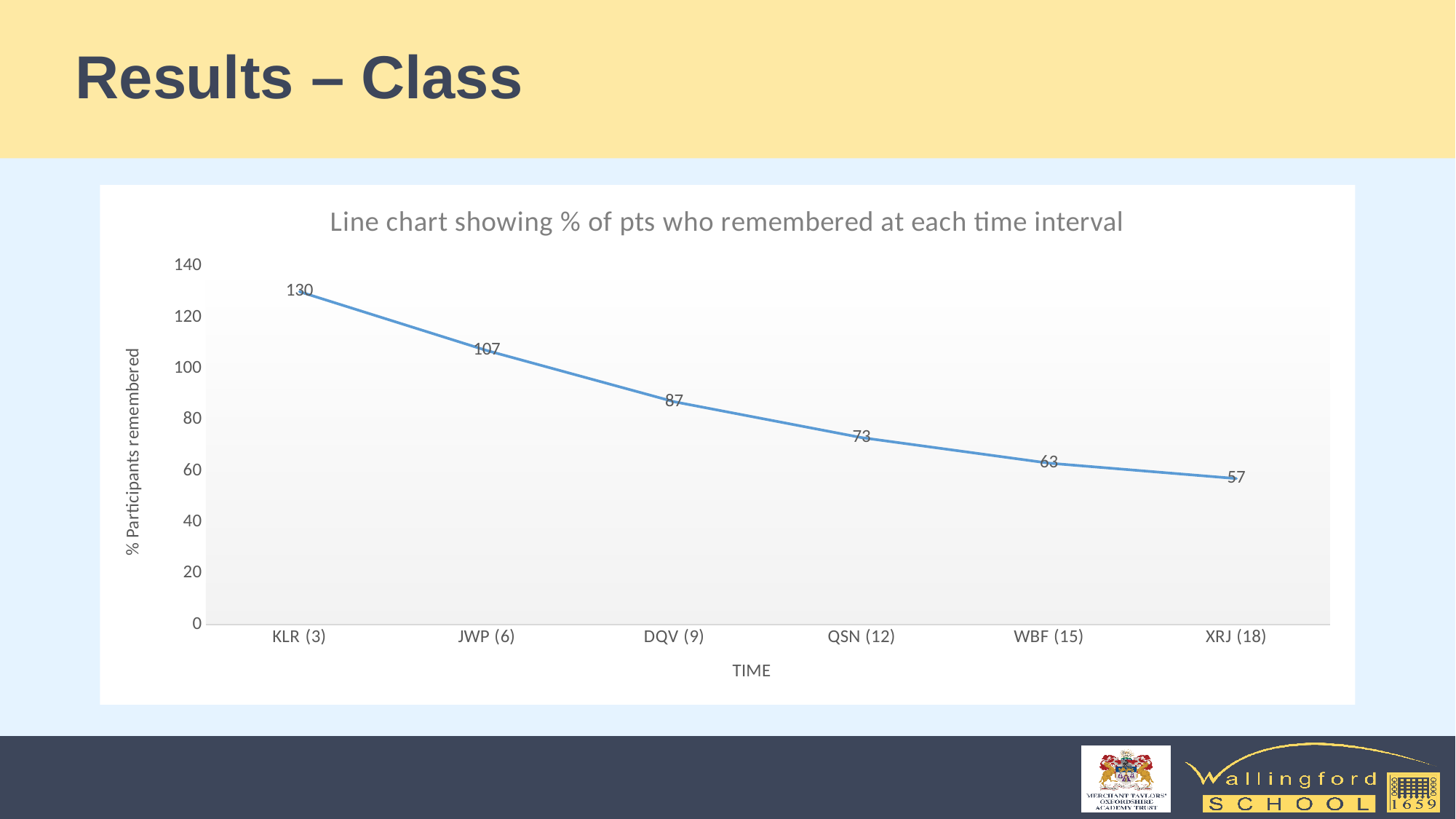
Is the value for QSN (12) greater or less than 80? less What is the value for DQV (9)? 87 Which is larger, the value for JWP (6) or the value for DQV (9)? JWP (6) Which time interval has the lowest value? XRJ (18) What is the value for XRJ (18)? 57 What is the difference between the values for KLR (3) and JWP (6)? 23 What is the value for KLR (3)? 130 Do the values rise or fall from KLR (3) to XRJ (18)? fall Which time interval has the highest value? KLR (3) What is the difference between the values for QSN (12) and WBF (15)? 10 What kind of chart is shown on the slide? line chart How many time intervals are plotted on the x axis? 6